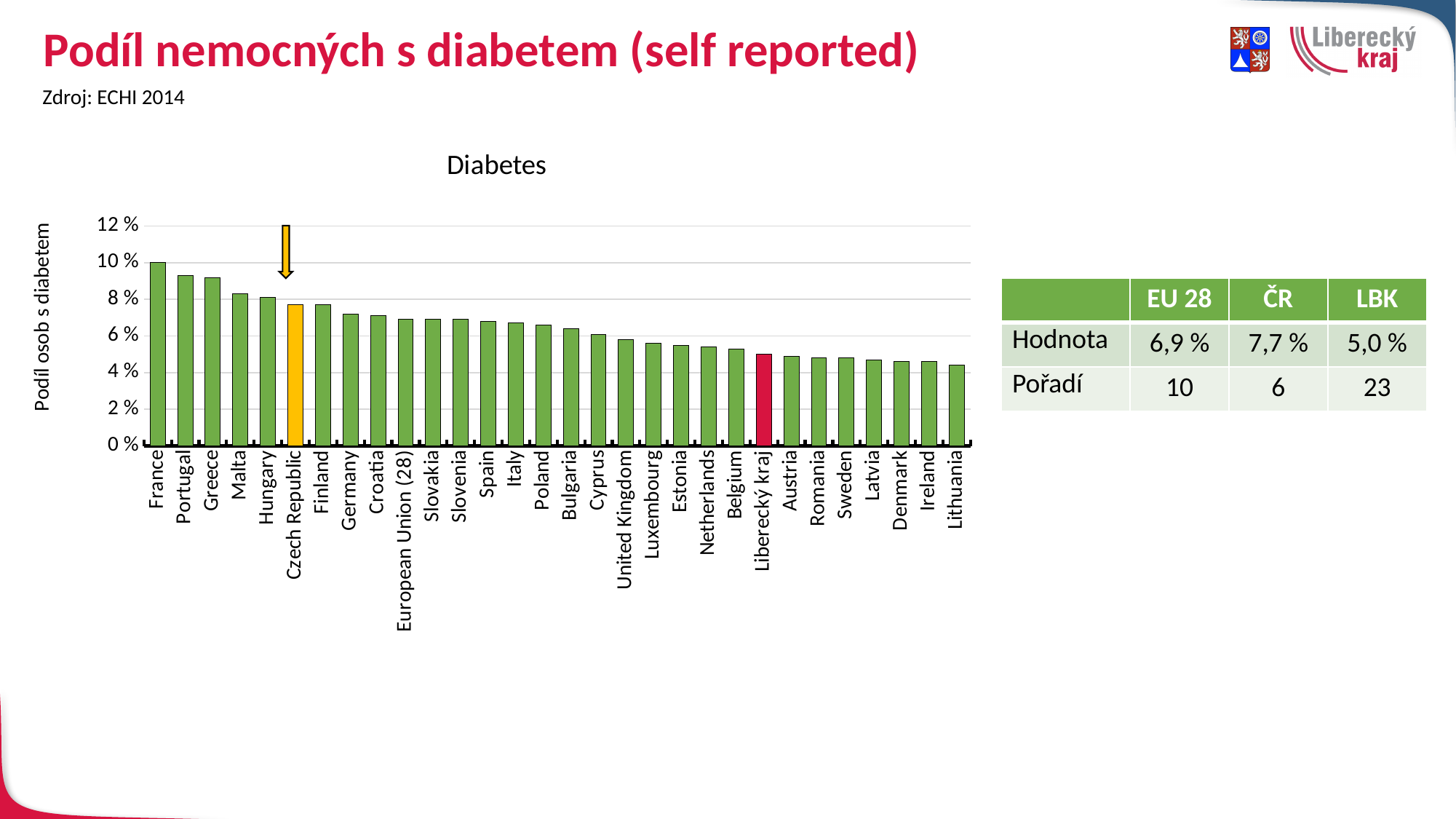
According to the table, what is the value for EU 28? 6,9 % According to the table, what is the value for ČR (Czech Republic)? 7,7 % Is the value for France greater or less than 8 %? greater How many categories (bars) are plotted in the chart? 30 Which category has the lowest value in the chart? Lithuania Do the values rise or fall moving from left to right along the x axis? fall Which category has the highest value in the chart? France According to the table, what is the value for LBK (Liberecký kraj)? 5,0 % What type of chart is shown on the slide? bar chart What is the title of the chart? Diabetes Is the value for Lithuania greater or less than 6 %? less What is the difference between the value for ČR and the value for LBK shown in the table? 2,7 %